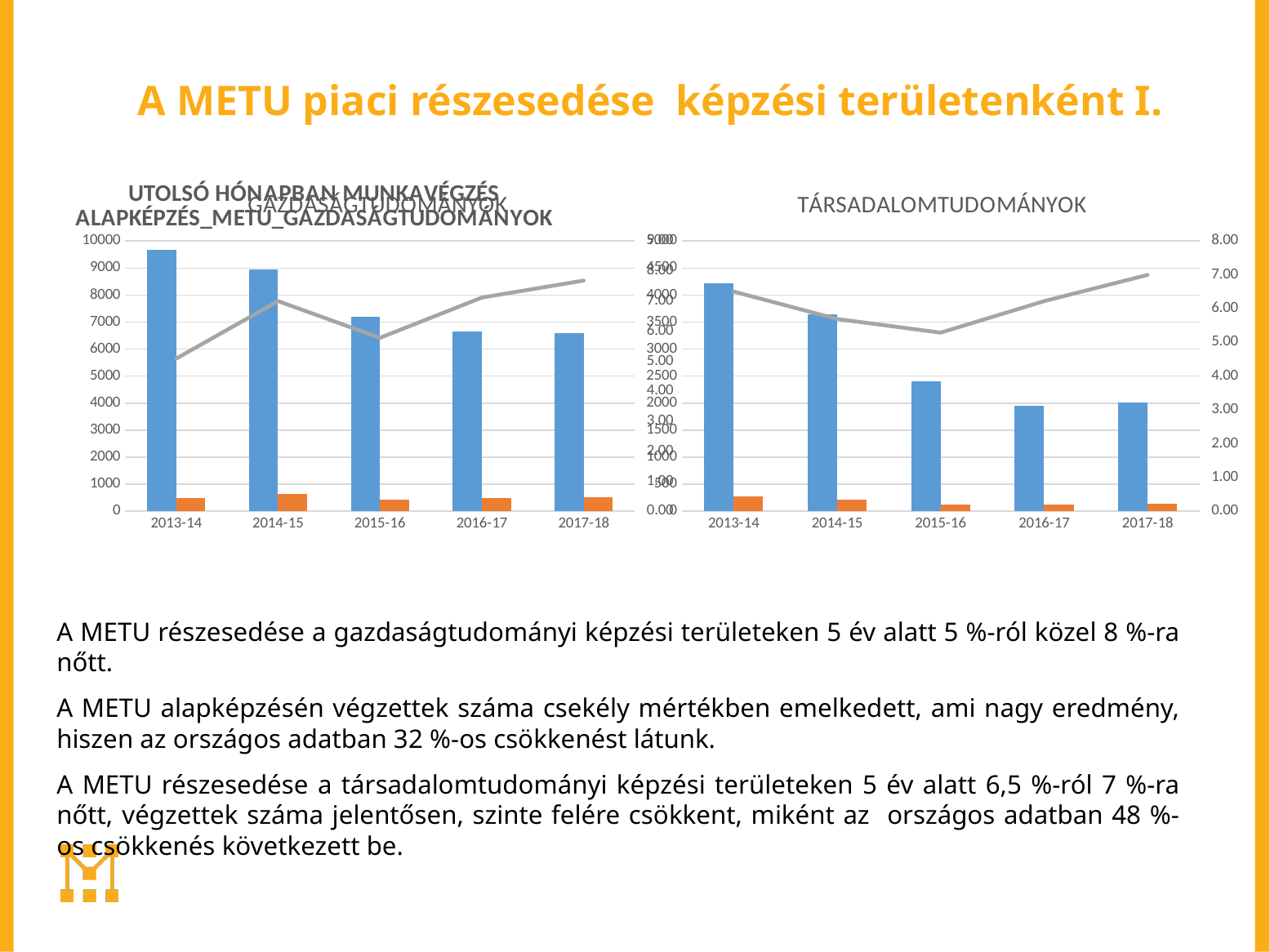
In the TÁRSADALOMTUDOMÁNYOK chart, is the blue bar for 2013-14 greater or less than 4000? greater In the TÁRSADALOMTUDOMÁNYOK chart, which year has the tallest blue bar? 2013-14 How many categories (academic years) are shown on the x axis of the TÁRSADALOMTUDOMÁNYOK chart? 5 In the TÁRSADALOMTUDOMÁNYOK chart, is the grey line value for 2017-18 greater or less than 6.00 on the right-hand axis? greater What is the title of the chart on the right side of the slide? TÁRSADALOMTUDOMÁNYOK In the TÁRSADALOMTUDOMÁNYOK chart, does the grey line rise or fall from 2015-16 to 2017-18? rises In the left chart (GAZDASÁGTUDOMÁNYOK), is the blue bar for 2016-17 greater or less than 7000? less In the left chart (GAZDASÁGTUDOMÁNYOK), which year has the tallest blue bar? 2013-14 What kind of chart is the TÁRSADALOMTUDOMÁNYOK chart on the right? bar chart with a line In the TÁRSADALOMTUDOMÁNYOK chart, which blue bar is taller: 2014-15 or 2015-16? 2014-15